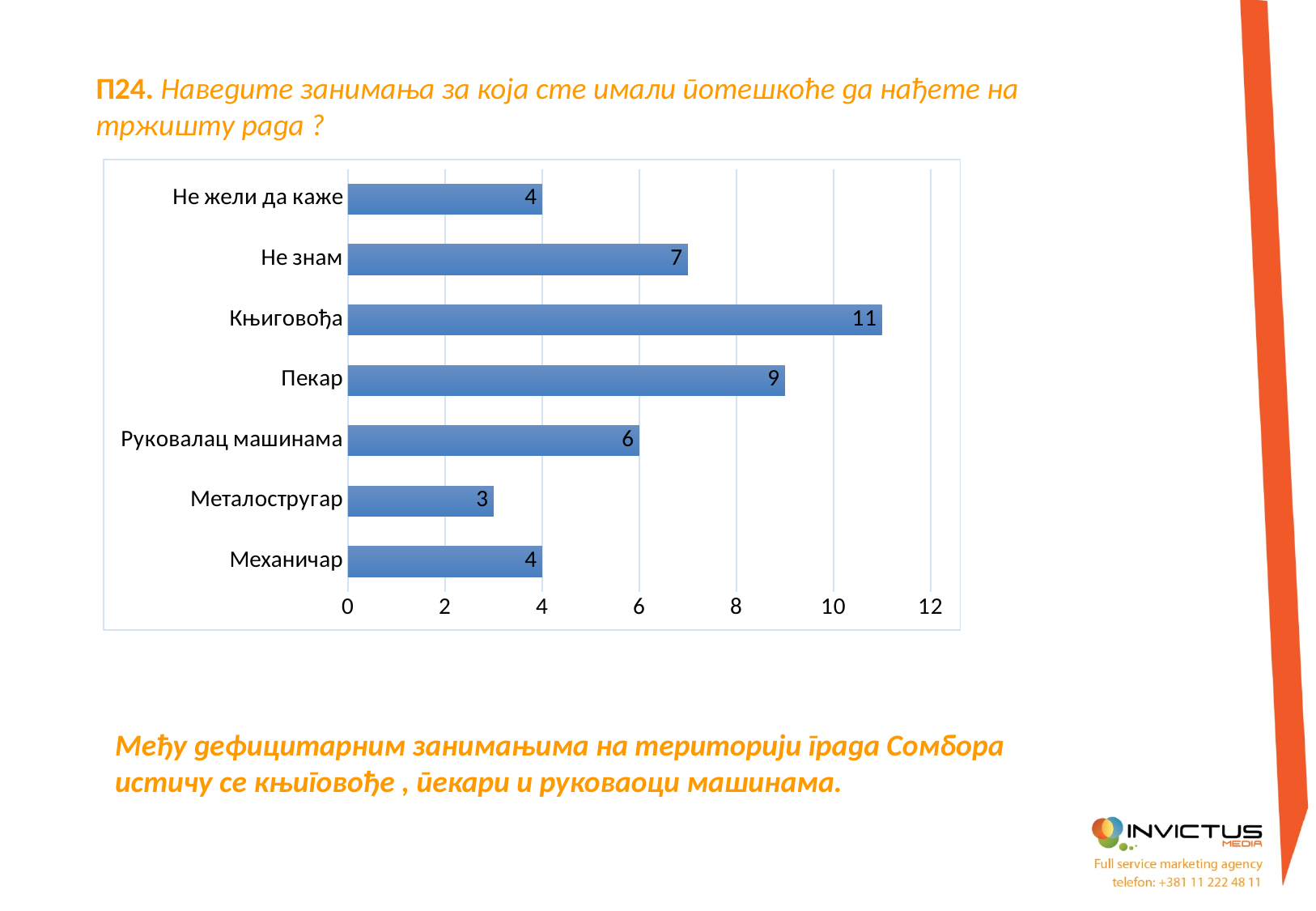
Which category has the lowest value? Металостругар What is the value for Књиговођа? 11 What is the value for Не знам? 7 Which category has the highest value? Књиговођа What kind of chart is shown on the slide? bar chart What is the difference between the values for Књиговођа and Пекар? 2 What is the difference between the values for Механичар and Металостругар? 1 Is the value for Пекар greater or less than 8? greater What is the value for Пекар? 9 What is the value for Руковалац машинама? 6 How many categories are shown in the chart? 7 Which is larger, the value for Не знам or the value for Руковалац машинама? Не знам